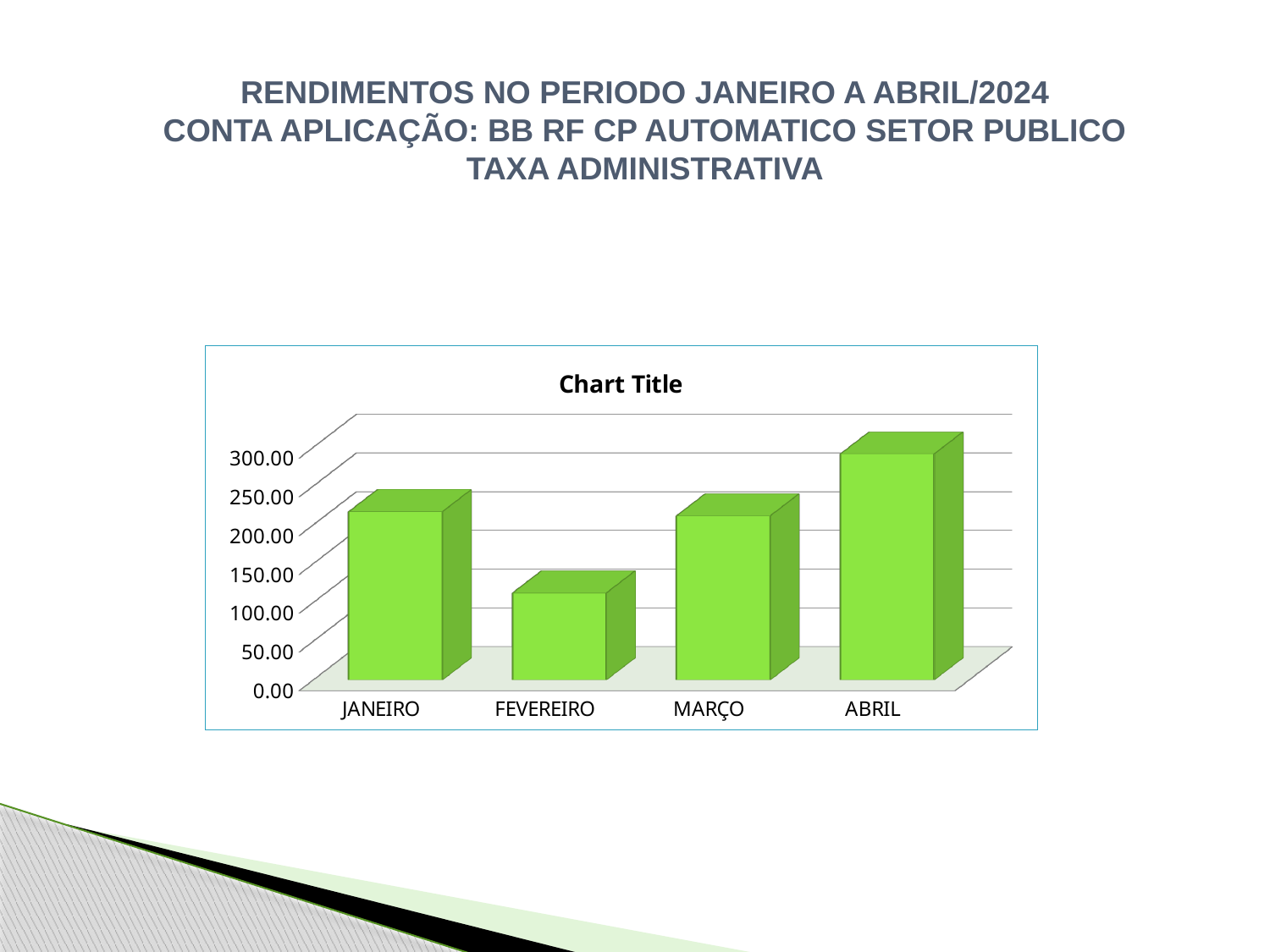
Is the value for ABRIL greater or less than 250.00? greater Which is larger, the value for JANEIRO or the value for FEVEREIRO? JANEIRO Is the value for JANEIRO greater or less than 200.00? greater Which is larger, the value for ABRIL or the value for MARÇO? ABRIL Is the value for FEVEREIRO greater or less than 150.00? less Which month has the highest value in the chart? ABRIL What kind of chart is shown on the slide? bar chart Which month has the lowest value in the chart? FEVEREIRO How many categories are shown on the x axis of the chart? 4 What title is printed above the chart's plot area? Chart Title Does the value rise or fall from JANEIRO to FEVEREIRO? fall